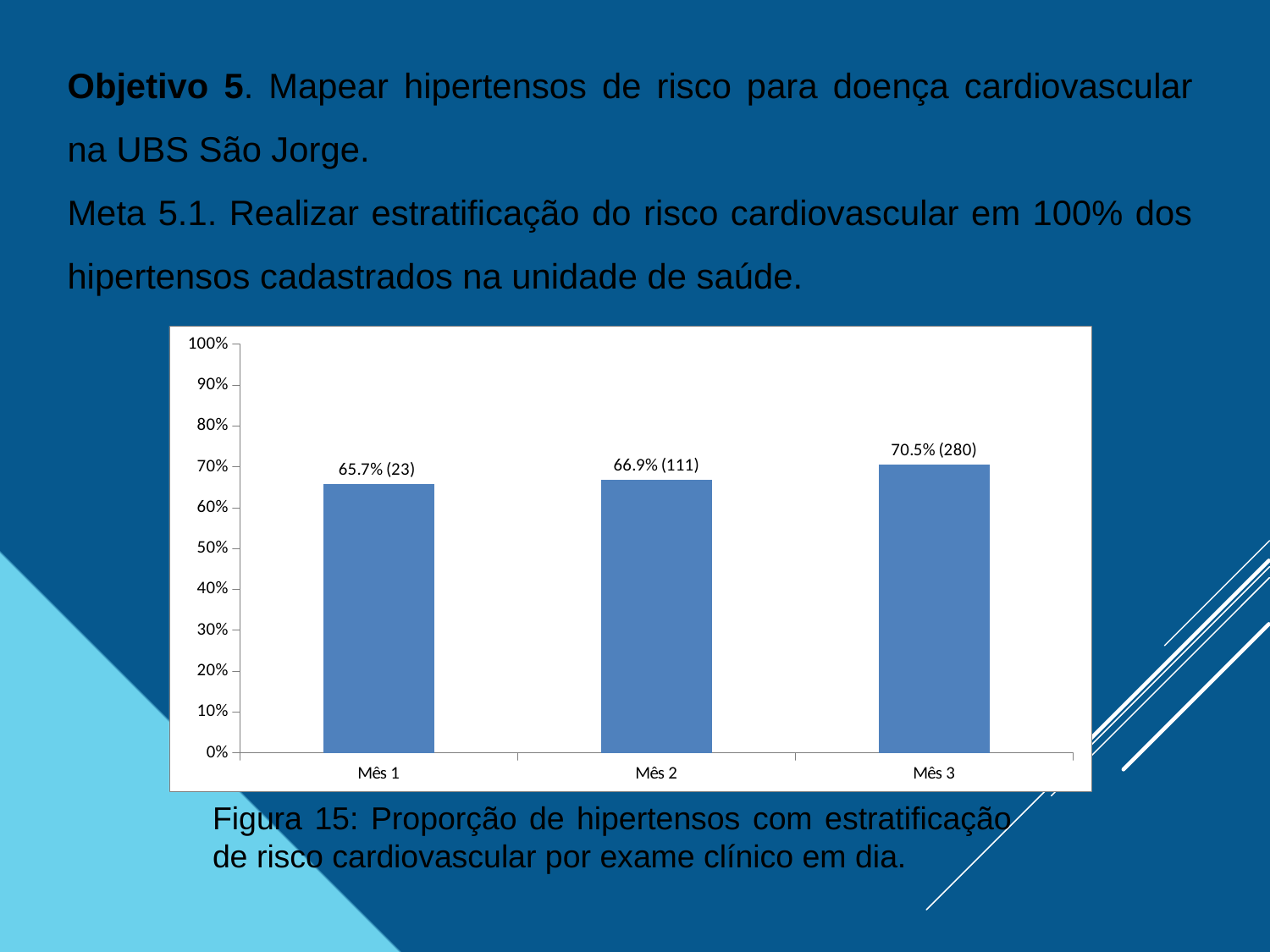
What is the value shown for Mês 3? 70.5% (280) Which is larger, the value for Mês 2 or the value for Mês 3? Mês 3 What kind of chart is shown on the slide? bar chart How many months are shown on the x axis? 3 Do the values rise or fall from Mês 1 to Mês 3? rise What is the value shown for Mês 1? 65.7% (23) Which month has the lowest proportion? Mês 1 Is the value for Mês 3 greater or less than 80%? less What is the value shown for Mês 2? 66.9% (111) What is the highest value shown on the y axis? 100% Which month has the highest proportion? Mês 3 What is the difference in percentage points between Mês 3 and Mês 1? 4.8